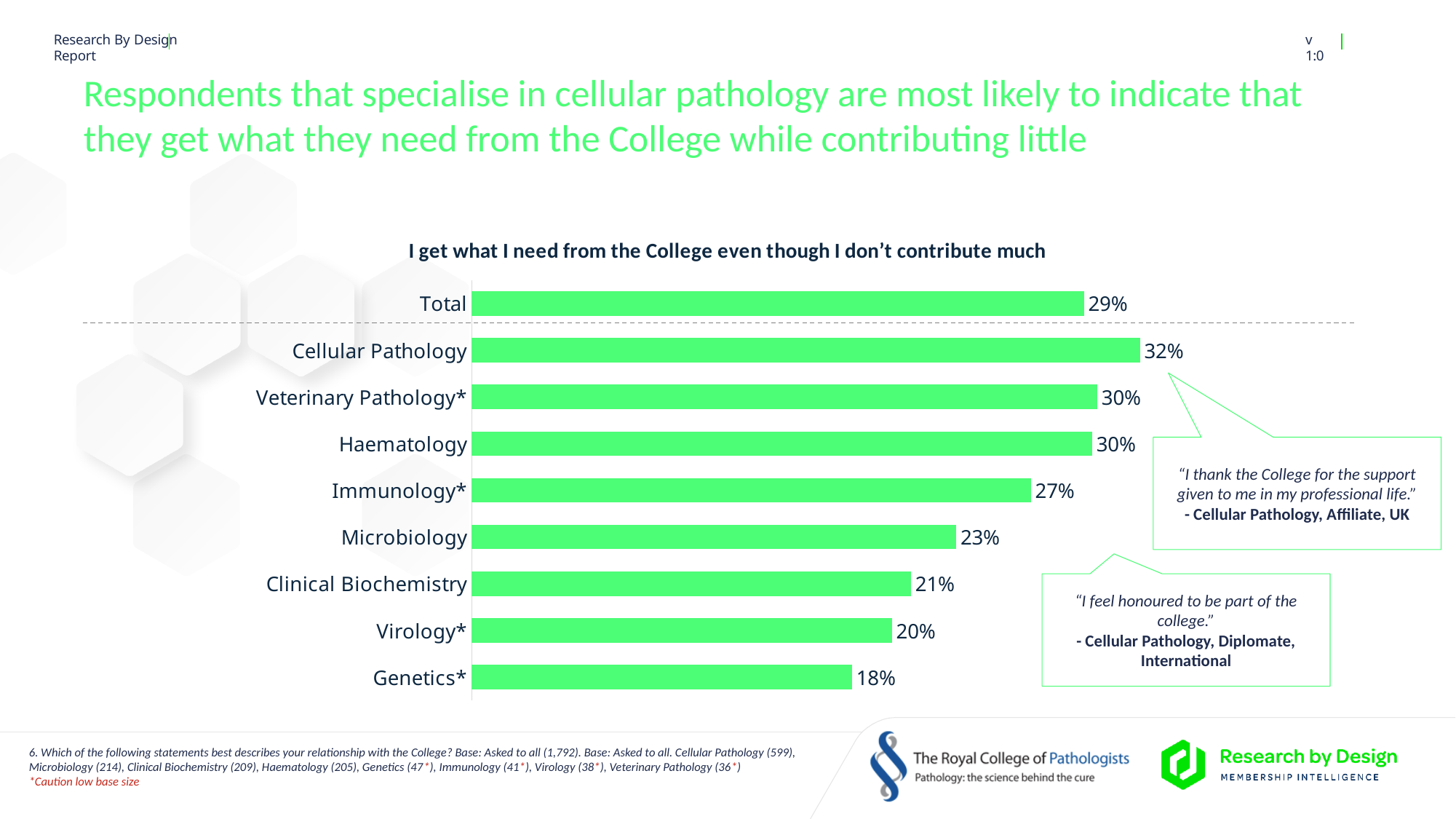
What is the value for Total? 29% Which is larger, the value for Clinical Biochemistry or the value for Microbiology? Microbiology Which category has the highest value? Cellular Pathology What is the value for Microbiology? 23% How many categories are shown in the chart? 9 What is the value for Genetics*? 18% What is the title of the chart? I get what I need from the College even though I don't contribute much What is the difference between the values for Cellular Pathology and Genetics*? 14% Which category has the lowest value? Genetics* What is the value for Cellular Pathology? 32% What is the difference between the values for Immunology* and Virology*? 7% What kind of chart is shown on the slide? Bar chart